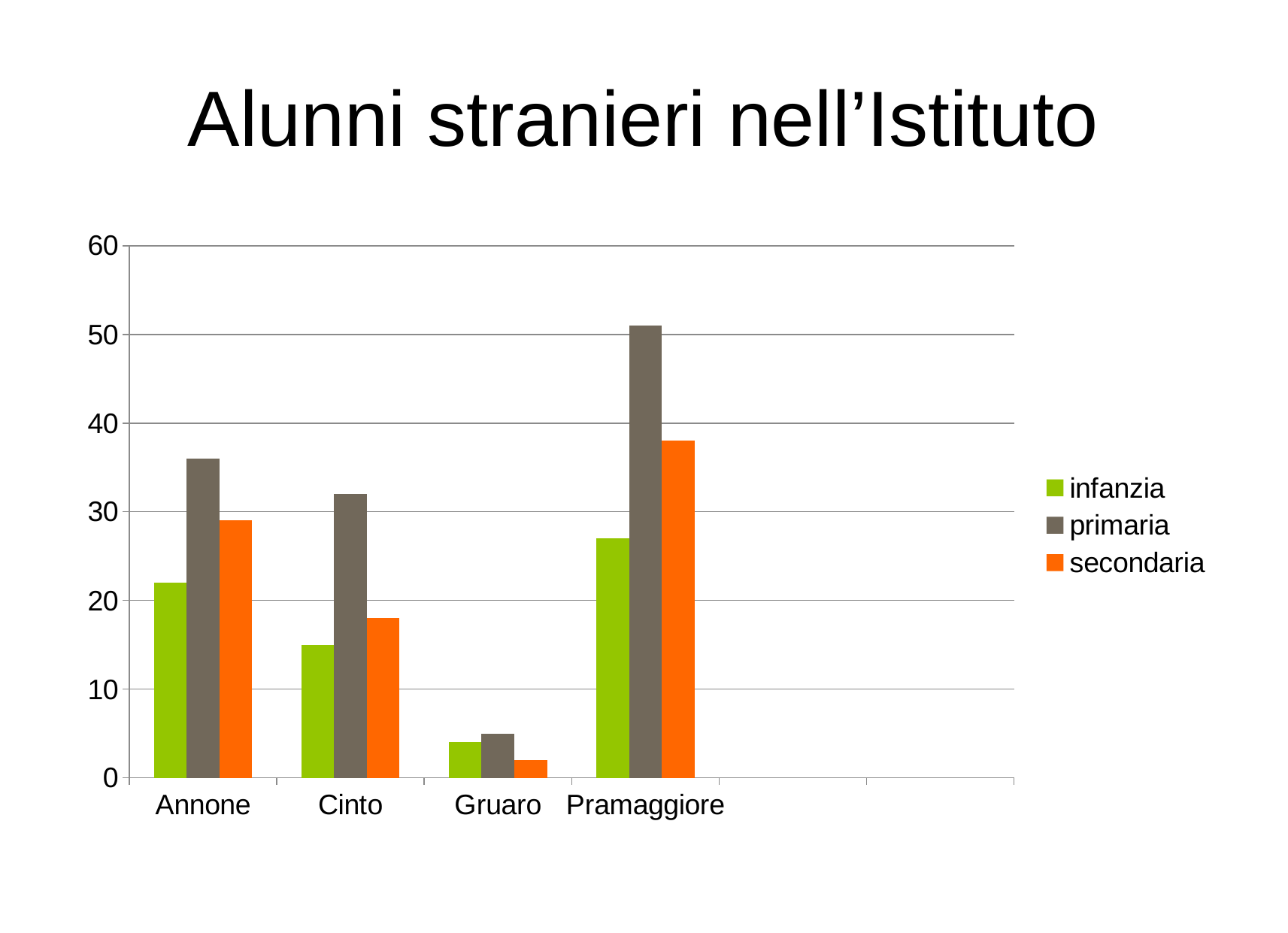
What is the title of the chart? Alunni stranieri nell'Istituto Which category has the highest value for the primaria series? Pramaggiore Which category has the lowest value for the infanzia series? Gruaro Which category has the lowest value for the secondaria series? Gruaro Which colour represents the secondaria series in the legend? orange Is the value for infanzia in Annone greater or less than 20? greater How many categories are shown on the x axis? 4 What kind of chart is shown on the slide? bar chart How many series does the legend list? 3 Is the value for secondaria in Cinto greater or less than 20? less Which is larger in Annone, the primaria value or the secondaria value? primaria